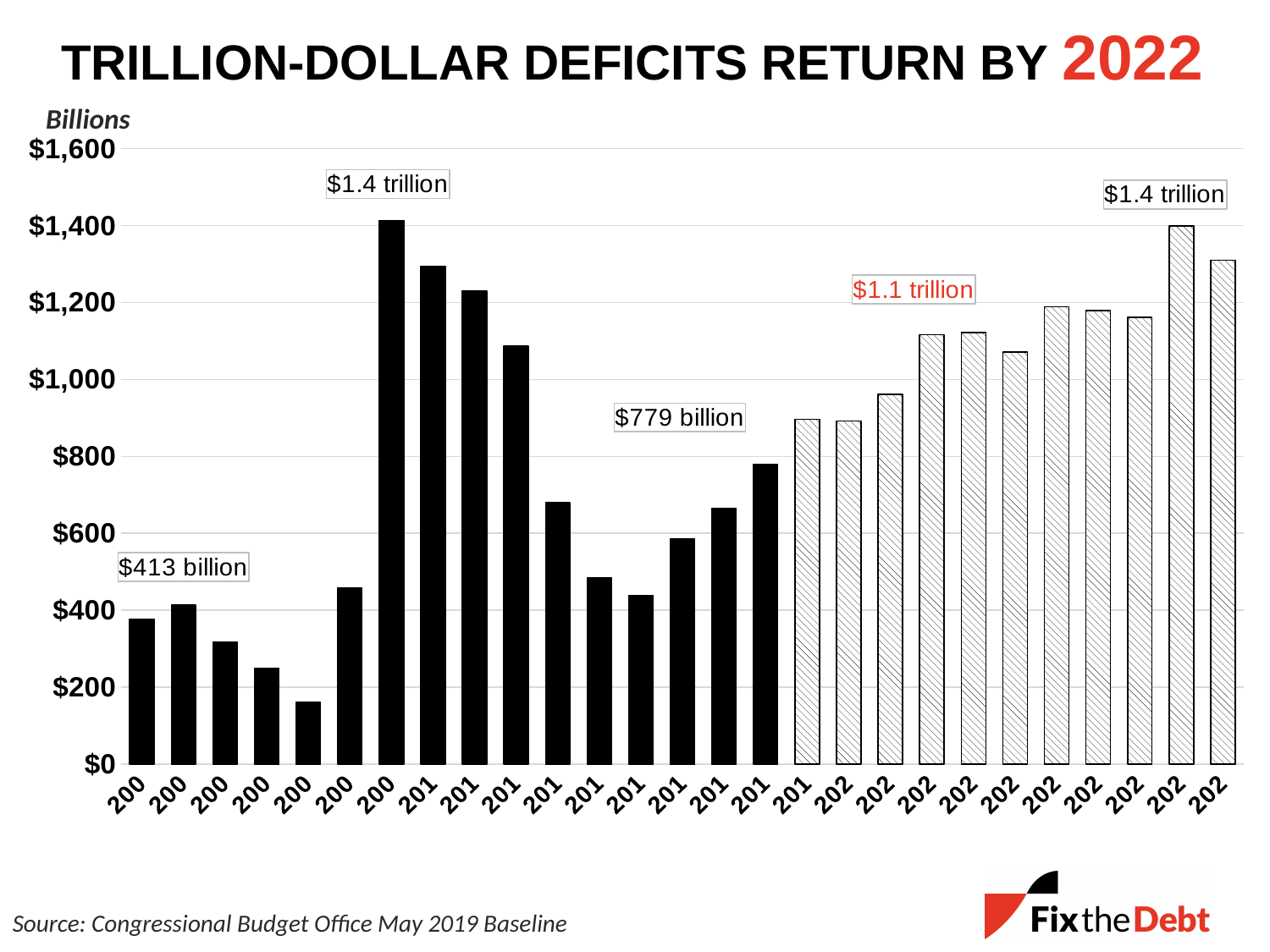
How many bars are plotted in the chart? 27 What kind of chart is shown on the slide? bar chart What value is labeled on the tallest solid black bar? $1.4 trillion What value is labeled near the second bar from the left? $413 billion Is the value of the last (rightmost) bar greater or less than $1,200? greater Is the value of the fifth bar from the left greater or less than $200? less Which is larger, the first (leftmost) bar or the last (rightmost) bar? the last (rightmost) bar What value is labeled on the last (rightmost) solid black bar? $779 billion What value is labeled in red text on the chart? $1.1 trillion Is the value of the first (leftmost) bar greater or less than $600? less Do the hatched bars on the right side of the chart generally rise or fall from left to right? rise What unit is indicated above the vertical axis? Billions